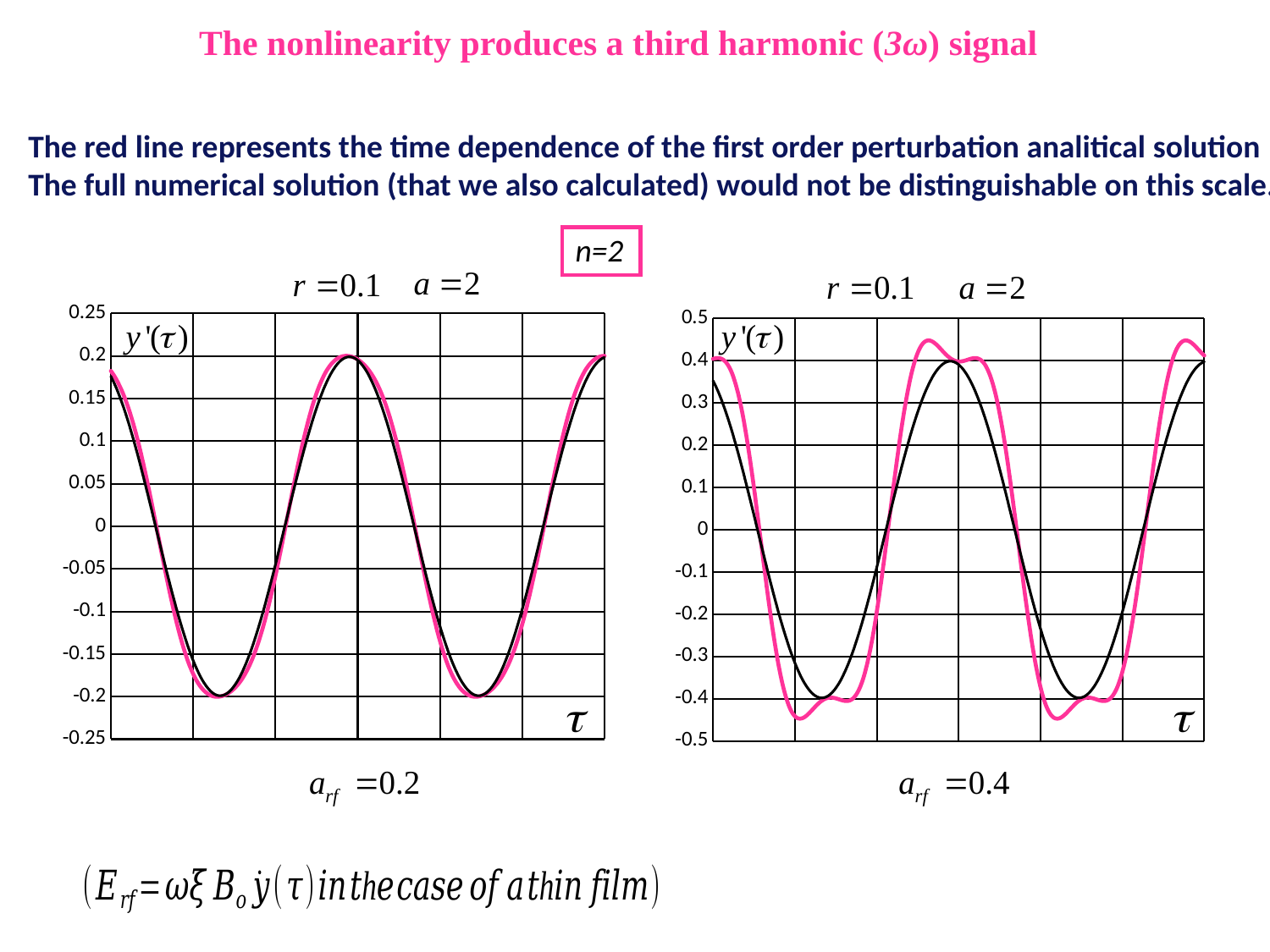
On the left chart (a_rf = 0.2), is the highest value reached by the black line greater or less than 0.25? less What is the maximum value shown on the vertical axis of the left chart (a_rf = 0.2)? 0.25 On the right chart (a_rf = 0.4), which line reaches a higher peak value, the red line or the black line? the red line What is the minimum value shown on the vertical axis of the right chart (a_rf = 0.4)? -0.5 What kind of chart is the right chart (a_rf = 0.4)? line chart On the left chart (a_rf = 0.2), is the lowest value reached by the black line greater or less than -0.25? greater On the right chart (a_rf = 0.4), is the highest value reached by the black line greater or less than 0.5? less How many lines are plotted on the left chart (a_rf = 0.2)? 2 How many lines are plotted on the right chart (a_rf = 0.4)? 2 What kind of chart is the left chart (a_rf = 0.2)? line chart